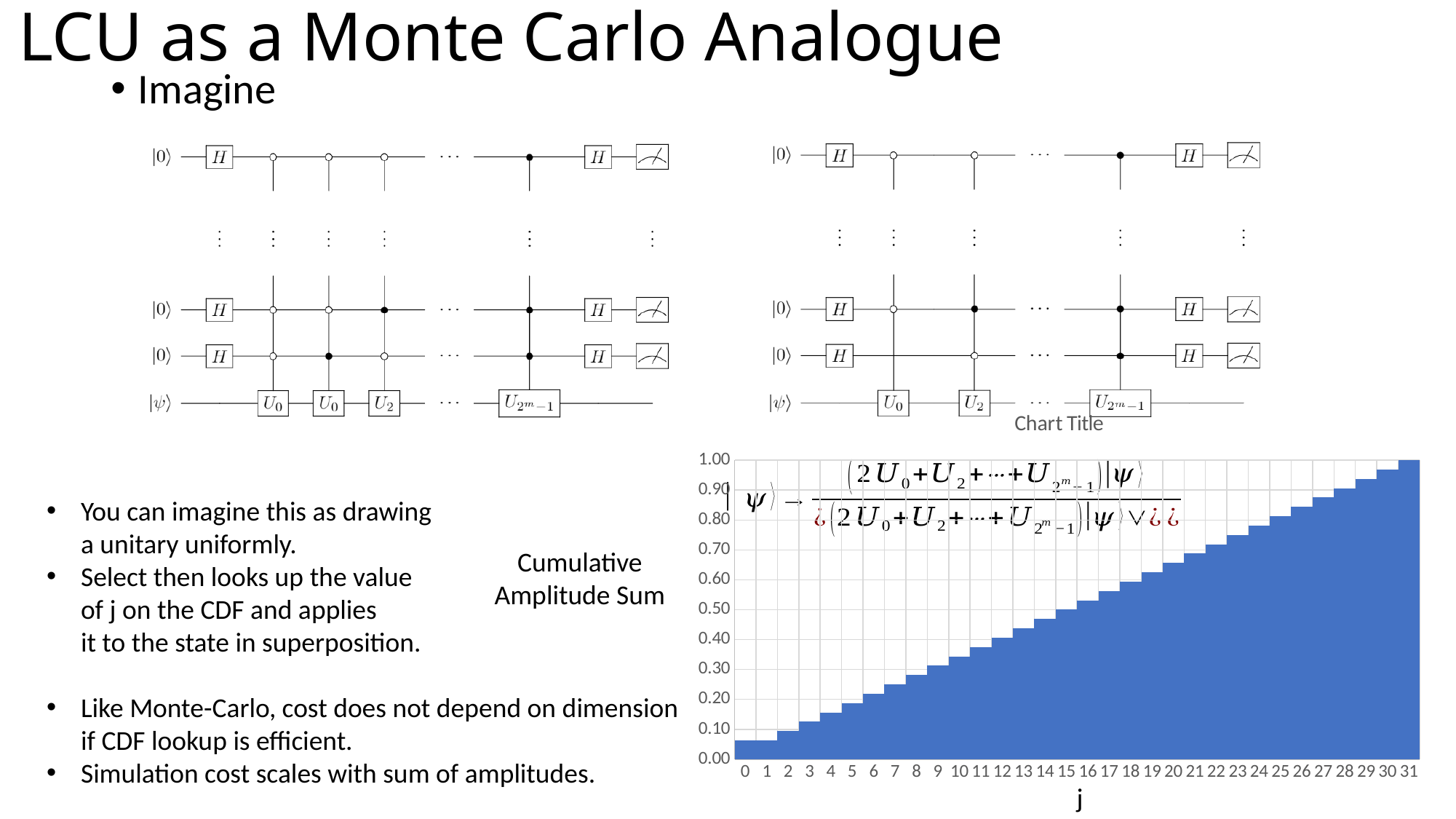
How many categories are plotted along the x axis of the chart? 32 Which is larger, the value for j = 5 or the value for j = 28? j = 28 What kind of chart is shown on the slide? bar chart Do the values in the chart rise or fall as j increases? rise Is the value for j = 10 greater or less than 0.30? greater What is the title shown above the chart? Chart Title What label is shown on the x axis of the chart? j Which value of j has the highest value in the chart? 31 Which value of j has the lowest value in the chart? 0 and 1 (tied) Is the value for j = 20 greater or less than 0.60? greater Is the value for j = 0 greater or less than 0.10? less